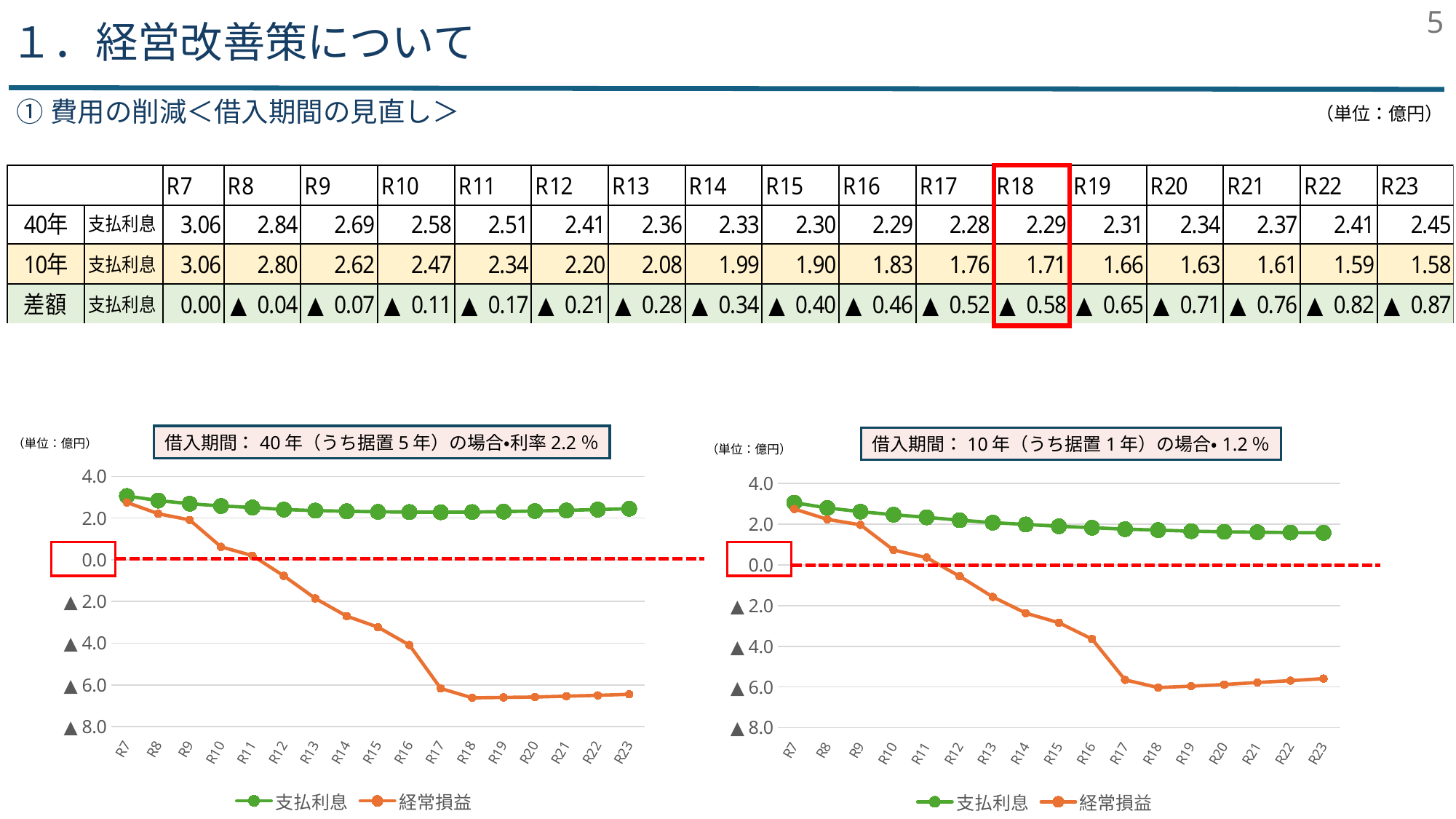
In the right chart (借入期間：10年), is the value for 支払利息 at R23 greater or less than 2.0? less In the right chart (借入期間：10年), which series has the larger value at R23, 支払利息 or 経常損益? 支払利息 What kind of chart is the left chart (借入期間：40年)? line chart How many points (years) are plotted along the x axis of the left chart (借入期間：40年)? 17 In the left chart (借入期間：40年), which colour is used for the 経常損益 line? orange In the right chart (借入期間：10年), is the value for 経常損益 at R13 greater or less than 0.0? less What is the title shown above the right chart? 借入期間：10年（うち据置1年）の場合・1.2% In the left chart (借入期間：40年), is the value for 経常損益 at R23 greater or less than ▲6.0? less How many series does the legend of the right chart (借入期間：10年) list? 2 In the left chart (借入期間：40年), does the 経常損益 line rise or fall from R7 to R23? fall In the right chart (借入期間：10年), does the 支払利息 line rise or fall from R7 to R23? fall